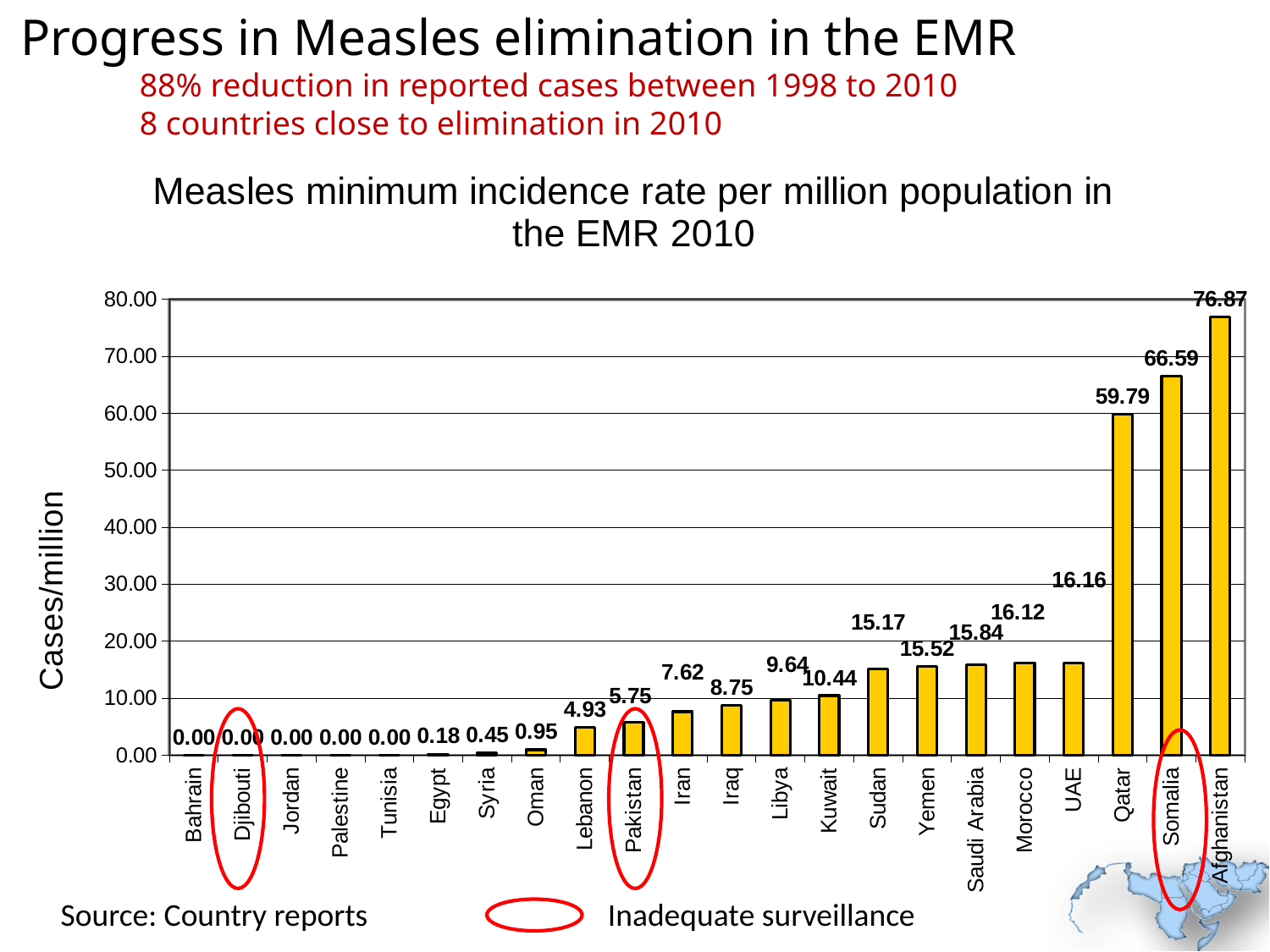
What is the difference between the values for Qatar and UAE? 43.63 How many countries are shown on the x axis of the chart? 22 What is the value shown for Pakistan? 5.75 Which country has the highest measles incidence rate in the chart? Afghanistan What is the measles incidence rate per million for Afghanistan? 76.87 Which has a higher incidence rate, Iraq or Libya? Libya What type of chart is shown on the slide? Bar chart What is the label of the y axis? Cases/million What is the value shown for Kuwait? 10.44 What is the value shown for Qatar? 59.79 Is the value for Somalia greater or less than 60.00? greater What is the difference between the values for Afghanistan and Somalia? 10.28